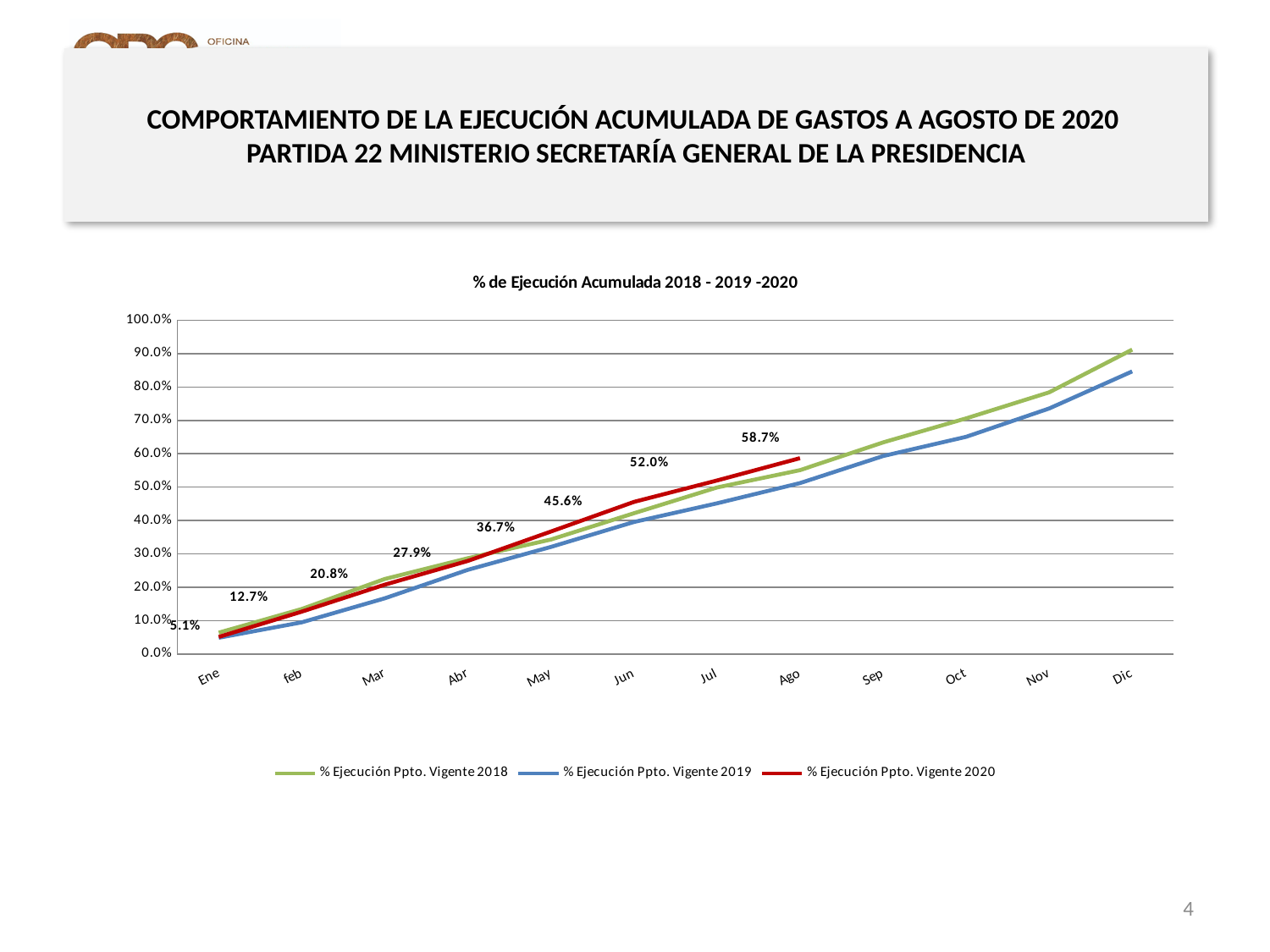
What type of chart is shown on the slide? line chart What is the value of % Ejecución Ppto. Vigente 2020 in Ago? 58.7% What is the difference between the % Ejecución Ppto. Vigente 2020 values for Mar and feb? 8.1% How many series does the legend list? 3 Does the % Ejecución Ppto. Vigente 2020 series rise or fall from Ene to Ago? rise What is the difference between the % Ejecución Ppto. Vigente 2020 values for Ago and Jul? 6.7% Is the value for % Ejecución Ppto. Vigente 2018 in Dic greater or less than 80.0%? greater What is the value of % Ejecución Ppto. Vigente 2020 in May? 36.7% What is the title of the chart? % de Ejecución Acumulada 2018 - 2019 -2020 What is the value of % Ejecución Ppto. Vigente 2020 in Ene? 5.1% How many months are shown on the x axis? 12 What is the value of % Ejecución Ppto. Vigente 2020 in Jun? 45.6%